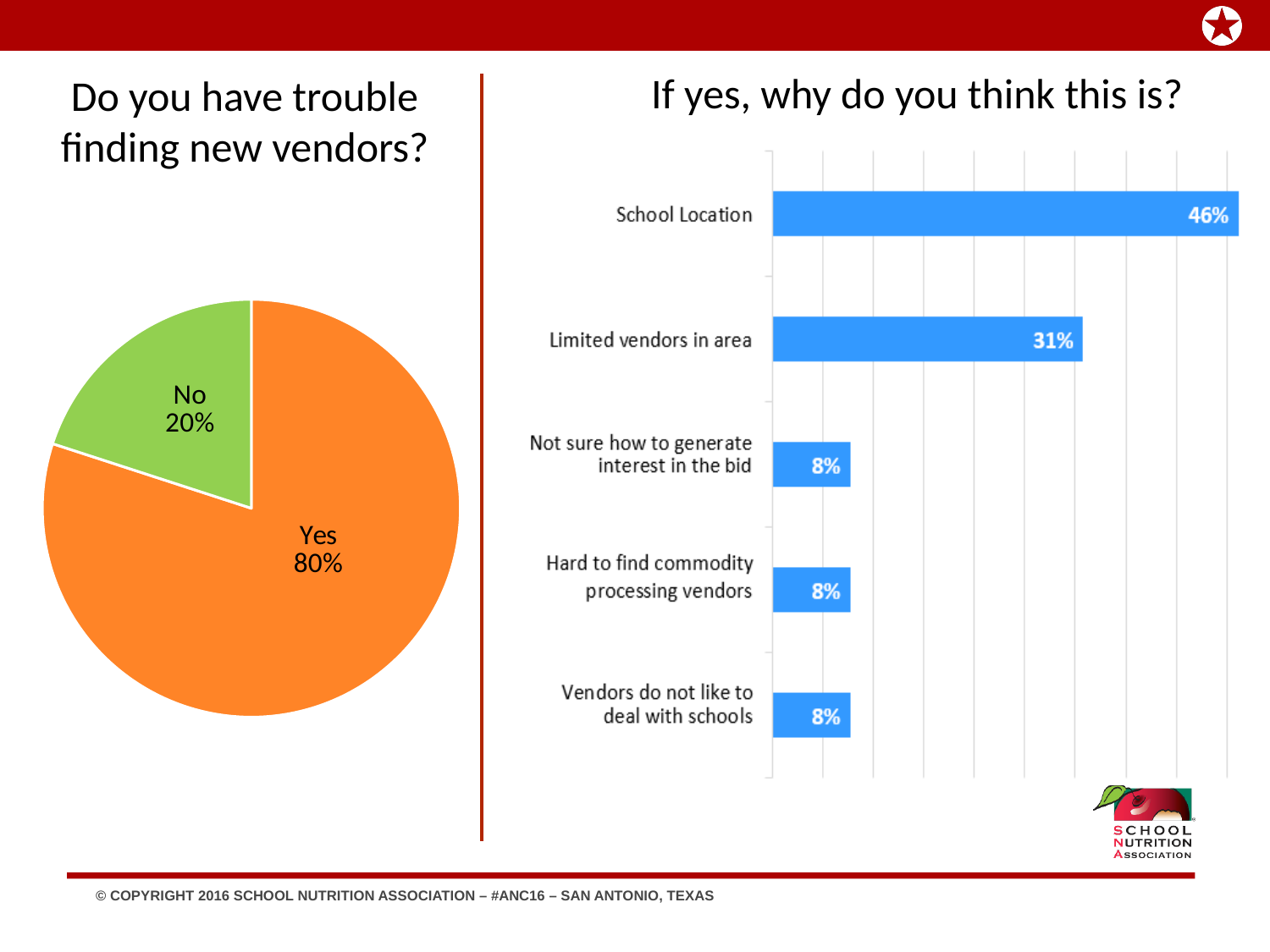
In the bar chart 'If yes, why do you think this is?', what is the value for Vendors do not like to deal with schools? 8% In the pie chart 'Do you have trouble finding new vendors?', how many slices are there? 2 In the bar chart 'If yes, why do you think this is?', which category has the highest value? School Location In the pie chart 'Do you have trouble finding new vendors?', what percentage answered Yes? 80% In the bar chart 'If yes, why do you think this is?', what is the difference between School Location and Limited vendors in area? 15% In the bar chart 'If yes, why do you think this is?', which is larger: Limited vendors in area or Hard to find commodity processing vendors? Limited vendors in area In the bar chart 'If yes, why do you think this is?', what is the value for School Location? 46% What kind of chart is the one on the right titled 'If yes, why do you think this is?'? bar chart In the bar chart 'If yes, why do you think this is?', how many categories are shown? 5 In the pie chart 'Do you have trouble finding new vendors?', what percentage answered No? 20% What kind of chart is the one on the left titled 'Do you have trouble finding new vendors?'? pie chart In the bar chart 'If yes, why do you think this is?', what is the value for Limited vendors in area? 31%